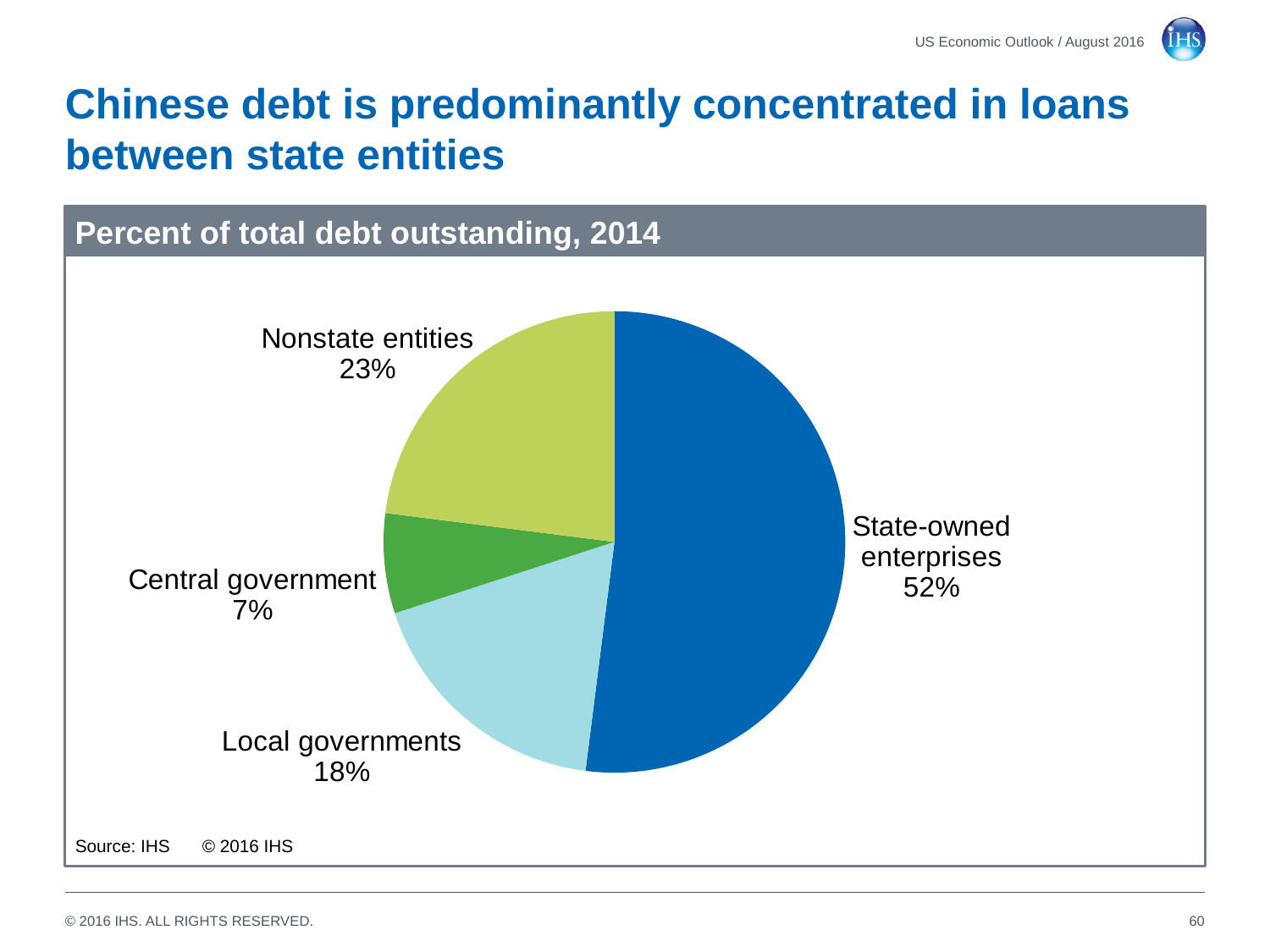
What type of chart is shown on the slide? Pie chart How many categories are shown in the pie chart? 4 Which category holds the smallest share of total debt outstanding? Central government What share of total debt outstanding is held by the central government? 7% What share of total debt outstanding is held by nonstate entities? 23% What share of total debt outstanding is held by state-owned enterprises? 52% Which holds a larger share of total debt outstanding, nonstate entities or local governments? Nonstate entities What is the difference in percentage points between the local governments share and the central government share? 11 How many percentage points larger is the state-owned enterprises share than the nonstate entities share? 29 Which category holds the largest share of total debt outstanding? State-owned enterprises What share of total debt outstanding is held by local governments? 18% What is the title of the chart? Percent of total debt outstanding, 2014